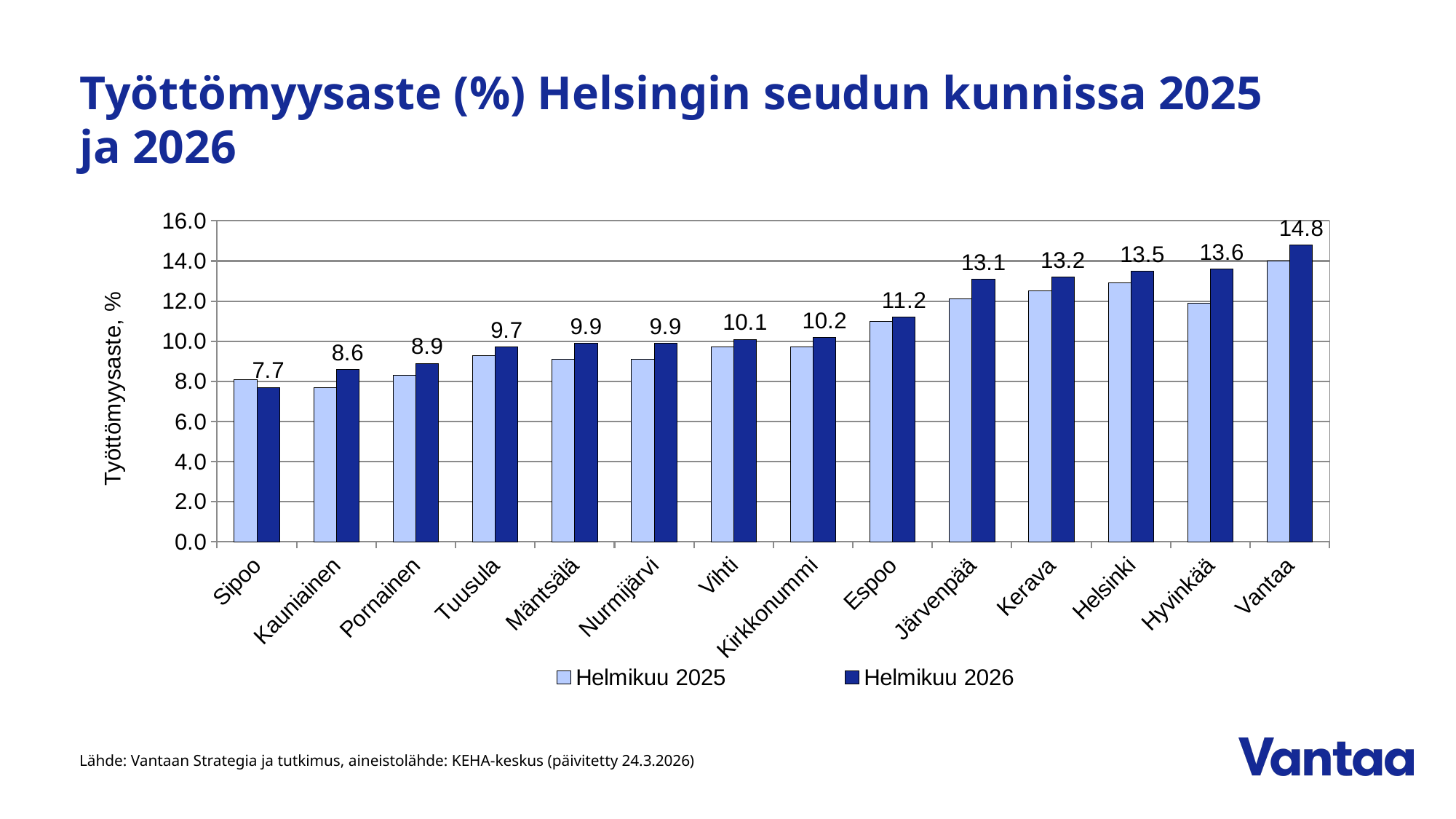
What is the difference between the Helmikuu 2026 values for Helsinki and Espoo? 2.3 Which municipality has the lowest Helmikuu 2026 unemployment rate? Sipoo What is the difference between the Helmikuu 2026 values for Vantaa and Sipoo? 7.1 What is the Helmikuu 2026 value for Kirkkonummi? 10.2 What is the Helmikuu 2026 value for Järvenpää? 13.1 How many municipalities are shown on the x axis? 14 Which municipality has the highest Helmikuu 2026 unemployment rate? Vantaa Is the Helmikuu 2025 value for Tuusula greater or less than 10.0? less For Sipoo, which is larger, the Helmikuu 2025 value or the Helmikuu 2026 value? Helmikuu 2025 What is the Helmikuu 2026 unemployment rate for Vantaa? 14.8 How many series does the legend list? 2 Is the Helmikuu 2025 value for Kerava greater or less than 12.0? greater